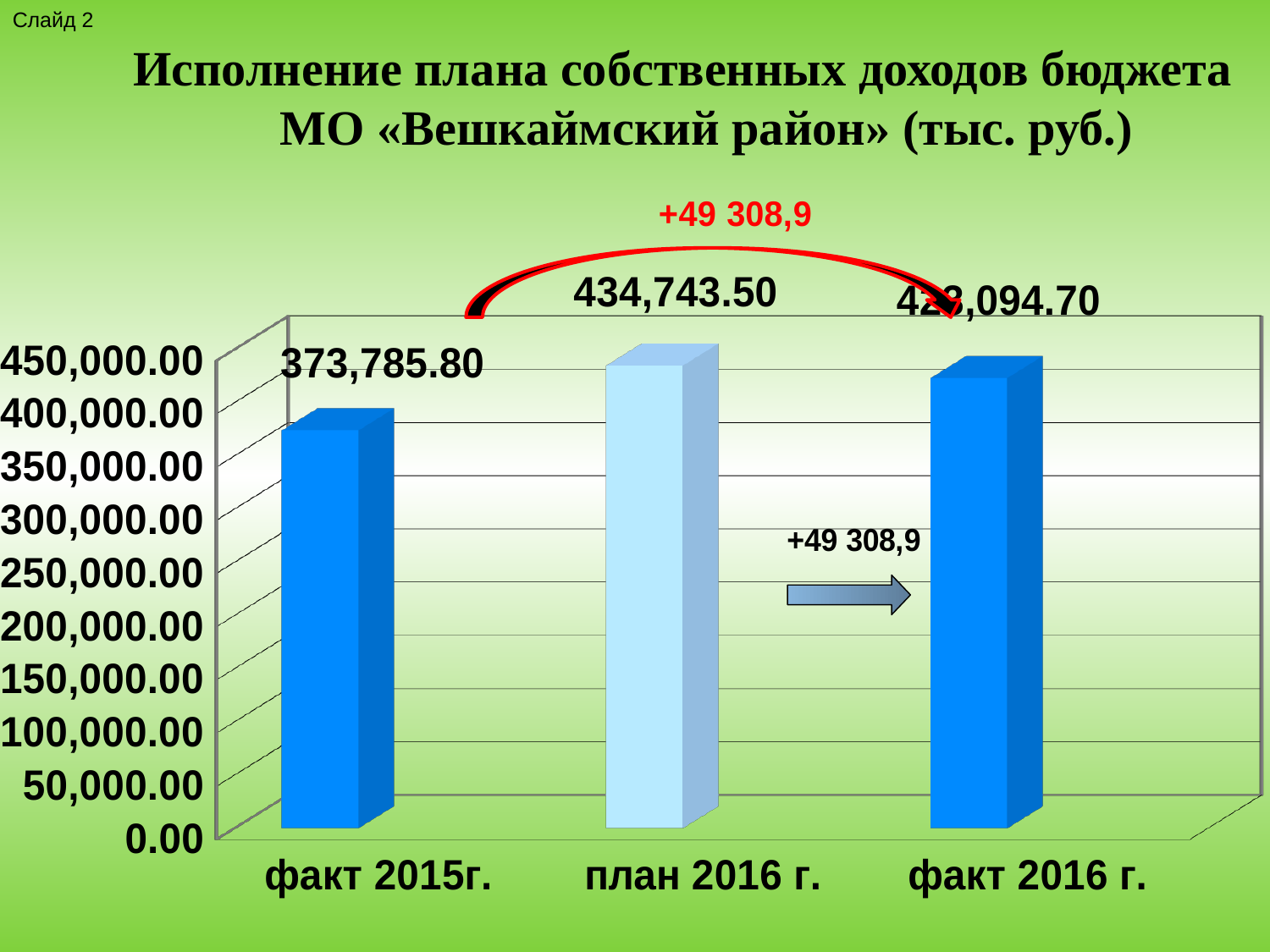
According to the annotation on the slide, by how much did факт 2016 г. exceed факт 2015г.? +49 308,9 Does the value rise or fall from факт 2015г. to план 2016 г.? rise What is the value for план 2016 г.? 434,743.50 What kind of chart is shown on the slide? bar chart How many categories are shown on the x axis? 3 Is the value for факт 2015г. greater or less than 400,000.00? less What is the difference between план 2016 г. and факт 2015г.? 60,957.70 Which is larger, the value for план 2016 г. or the value for факт 2015г.? план 2016 г. Is the value for факт 2016 г. greater or less than 400,000.00? greater Which category has the lowest value? факт 2015г. What is the value for факт 2015г.? 373,785.80 Which category has the highest value? план 2016 г.